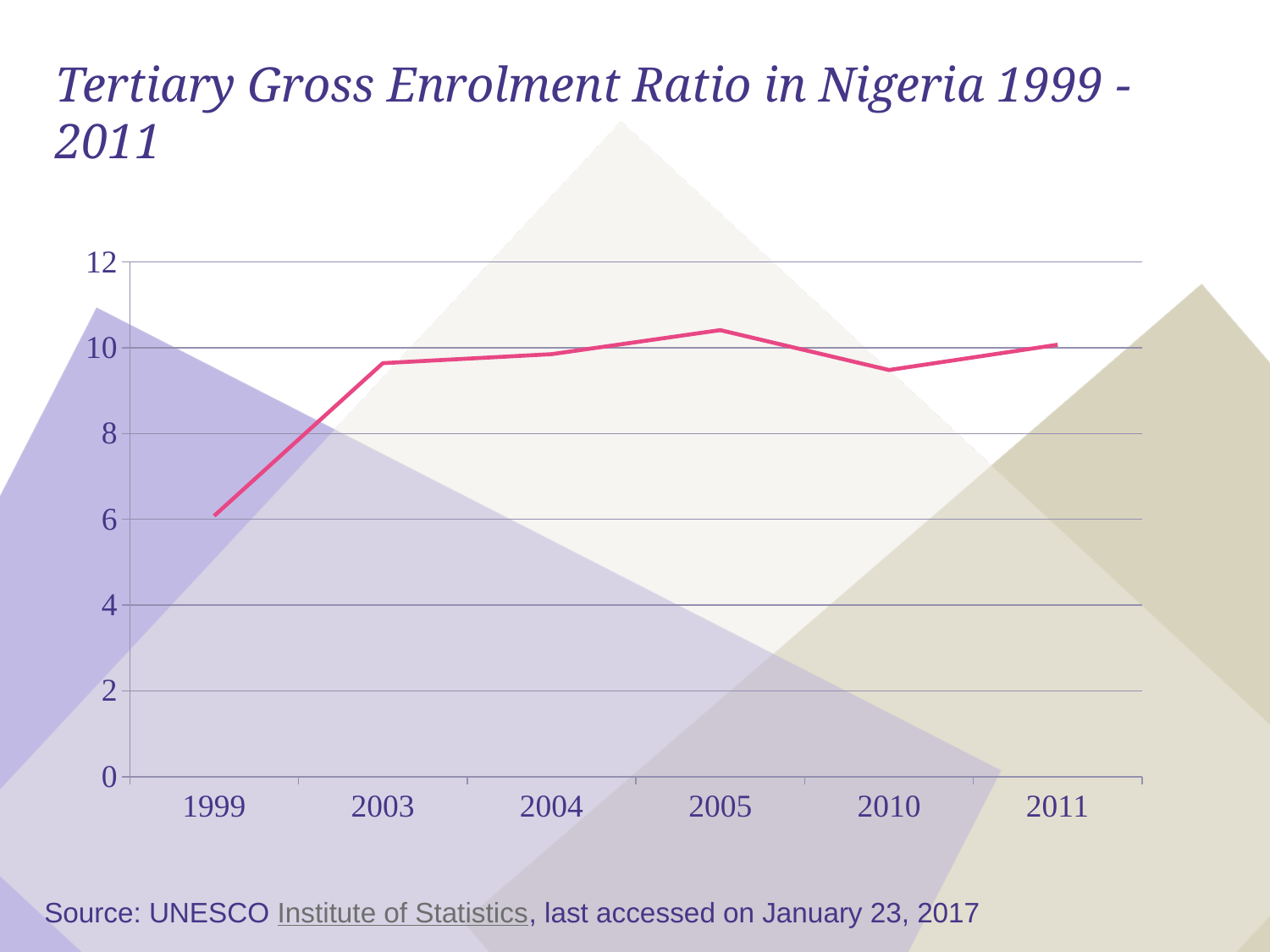
Is the value for 2003 greater or less than 8? greater Which year has the lowest tertiary gross enrolment ratio? 1999 Is the value for 2010 greater or less than 10? less Does the enrolment ratio rise or fall between 1999 and 2005? rise Which is larger, the value for 2005 or the value for 2010? 2005 What kind of chart is shown on the slide? line chart Which is larger, the value for 1999 or the value for 2003? 2003 Is the value for 2005 greater or less than 10? greater Which year has the highest tertiary gross enrolment ratio? 2005 What is the title of the chart? Tertiary Gross Enrolment Ratio in Nigeria 1999 - 2011 How many years are plotted on the x axis? 6